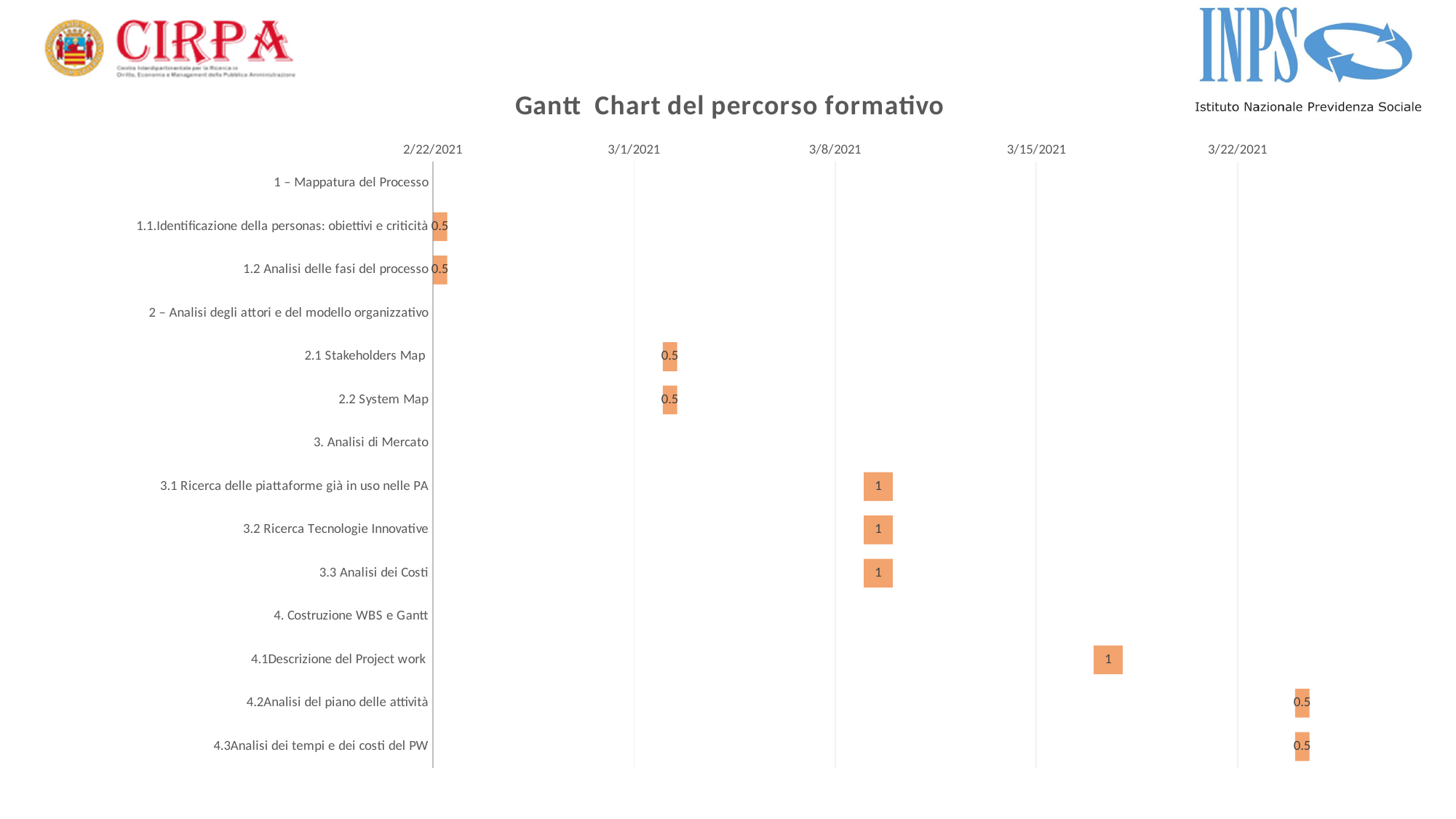
What is the duration value shown for "1.2 Analisi delle fasi del processo"? 0.5 What kind of chart is shown on the slide? Bar chart (Gantt chart) What is the duration value shown for "3.1 Ricerca delle piattaforme già in uso nelle PA"? 1 How many task rows (categories) are listed on the vertical axis of the chart? 14 Which is larger, the value for "3.3 Analisi dei Costi" or the value for "2.2 System Map"? 3.3 Analisi dei Costi What is the duration value shown for "4.1Descrizione del Project work"? 1 What is the first date shown on the horizontal axis of the chart? 2/22/2021 What is the duration value shown for "2.1 Stakeholders Map"? 0.5 What is the duration value shown for "4.3Analisi dei tempi e dei costi del PW"? 0.5 What is the title of the chart? Gantt Chart del percorso formativo How many bars are plotted in the chart? 10 What is the difference between the value for "3.2 Ricerca Tecnologie Innovative" and the value for "4.2Analisi del piano delle attività"? 0.5